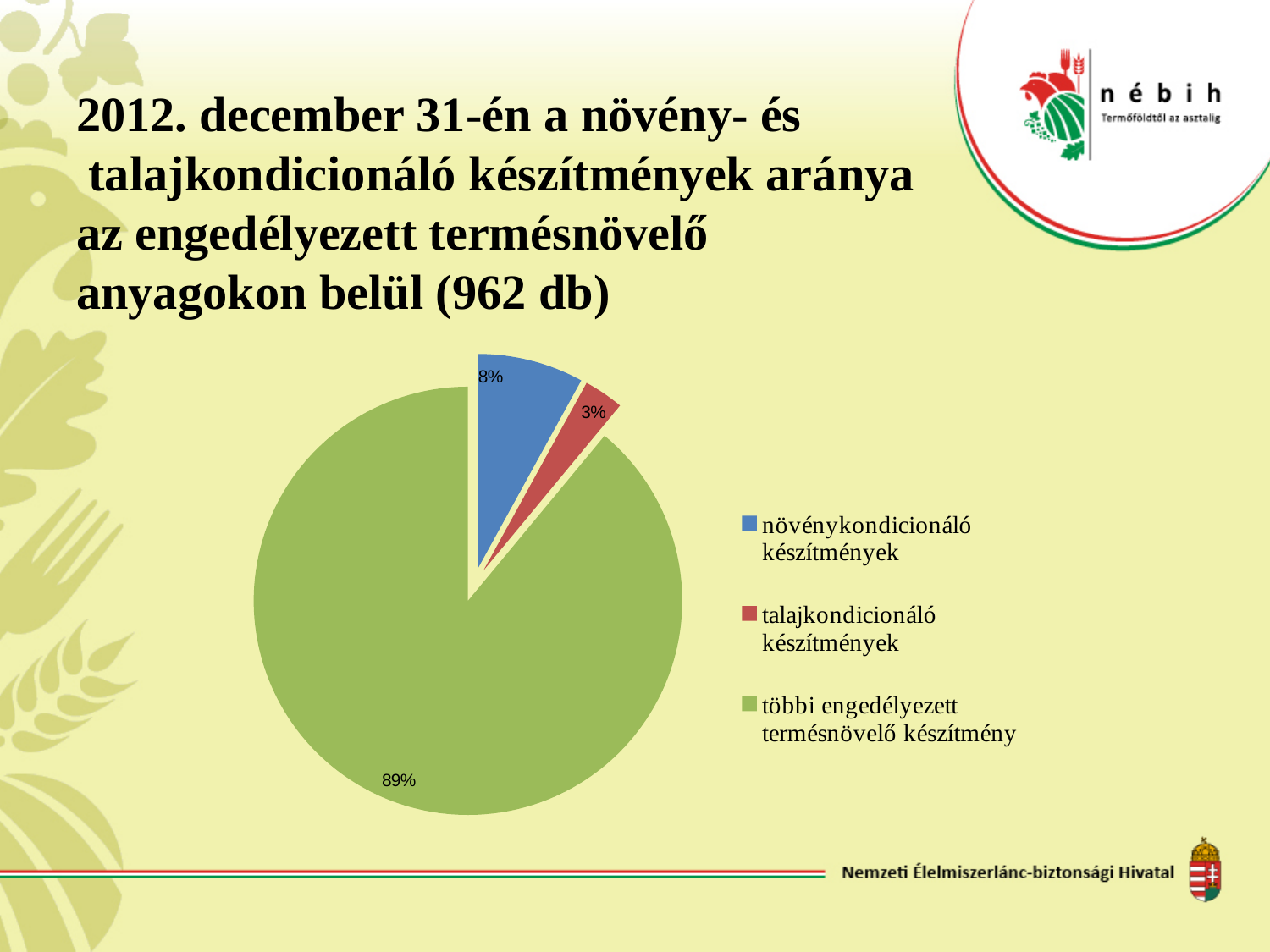
Which category has the largest slice of the pie? többi engedélyezett termésnövelő készítmény How many items does the legend list? 3 What share of the pie is labelled for növénykondicionáló készítmények? 8% What colour is the slice for talajkondicionáló készítmények? red What share of the pie is labelled for talajkondicionáló készítmények? 3% What share of the pie is labelled for többi engedélyezett termésnövelő készítmény? 89% Which is larger, the slice for növénykondicionáló készítmények or the slice for talajkondicionáló készítmények? növénykondicionáló készítmények Which category has the smallest slice of the pie? talajkondicionáló készítmények What is the difference in percentage points between the largest slice and the slice for növénykondicionáló készítmények? 81% What kind of chart is shown on the slide? pie chart What is the difference in percentage points between the slice for növénykondicionáló készítmények and the slice for talajkondicionáló készítmények? 5% How many categories does the pie chart show? 3